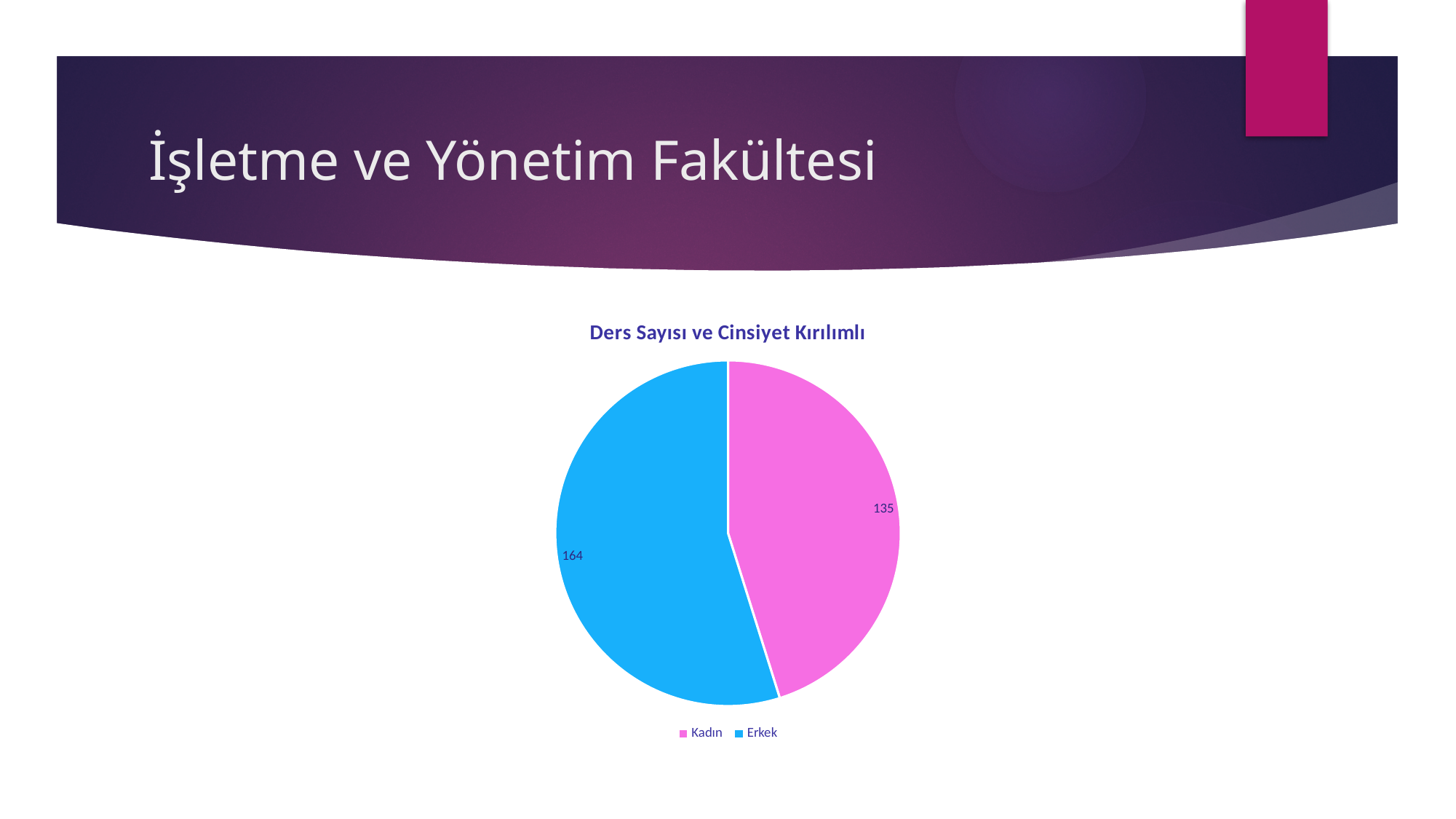
How many categories does the pie chart show? 2 What is the difference between the Erkek and Kadın values? 29 Which is larger, the value for Kadın or the value for Erkek? Erkek What is the total of all slices in the pie chart? 299 Which colour represents Erkek in the pie chart? Blue What is the value for Erkek in the pie chart? 164 What kind of chart is shown on the slide? Pie chart Which category has the largest slice in the pie chart? Erkek Which category has the smallest slice in the pie chart? Kadın What is the title of the chart? Ders Sayısı ve Cinsiyet Kırılımlı What is the value for Kadın in the pie chart? 135